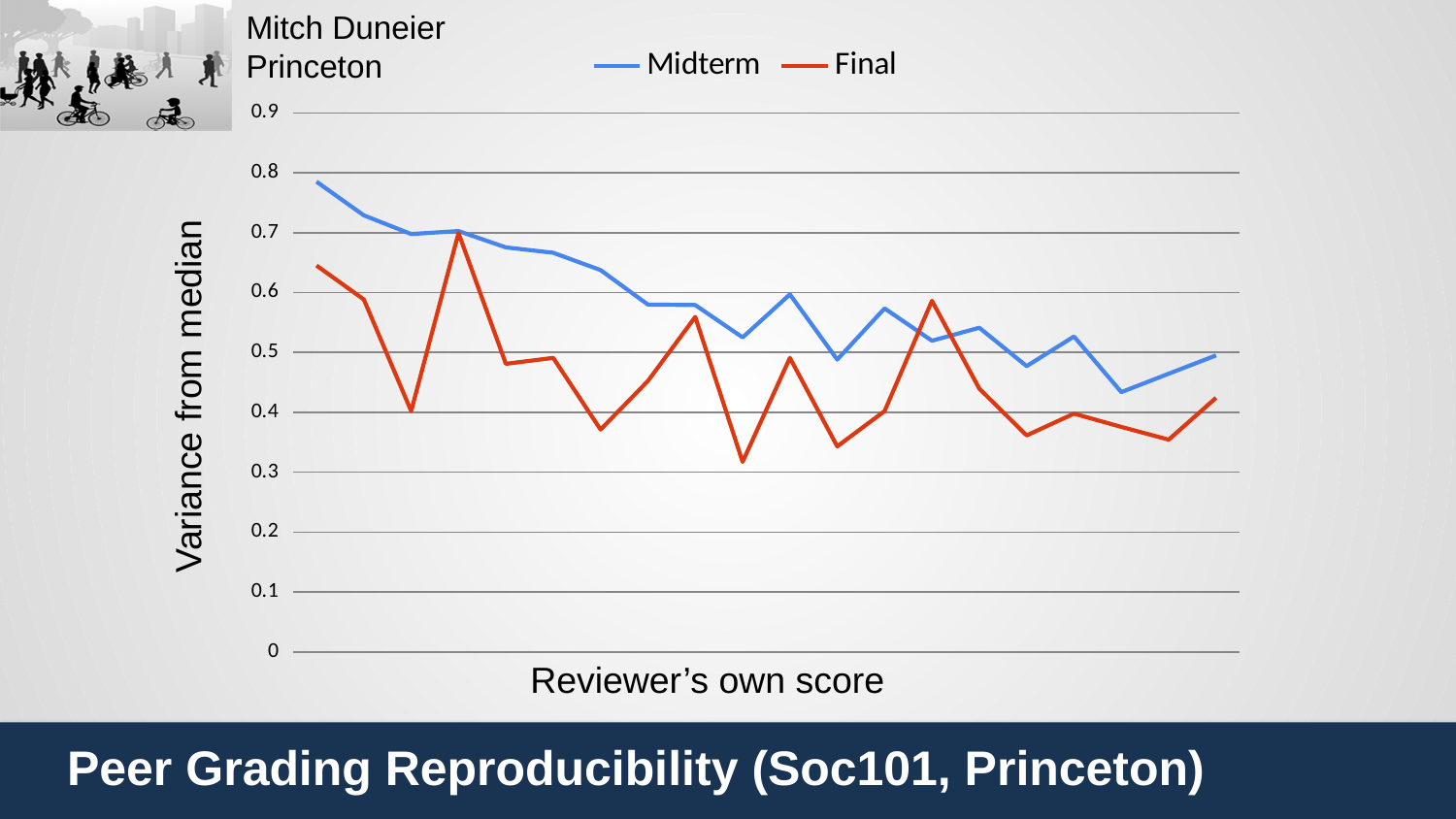
Is the rightmost value of the Midterm series greater or less than 0.4? greater Which series reaches the highest value on the chart? Midterm What are the two series named in the legend? Midterm and Final How many series does the legend list? 2 Is the leftmost value of the Midterm series greater or less than 0.7? greater What is the label on the vertical axis? Variance from median Does the Midterm line generally rise or fall from left to right? Fall Which series is drawn in red? Final What kind of chart is shown on the slide? Line chart Is the lowest value of the Final series greater or less than 0.4? less Which series has the higher value at the leftmost point, Midterm or Final? Midterm